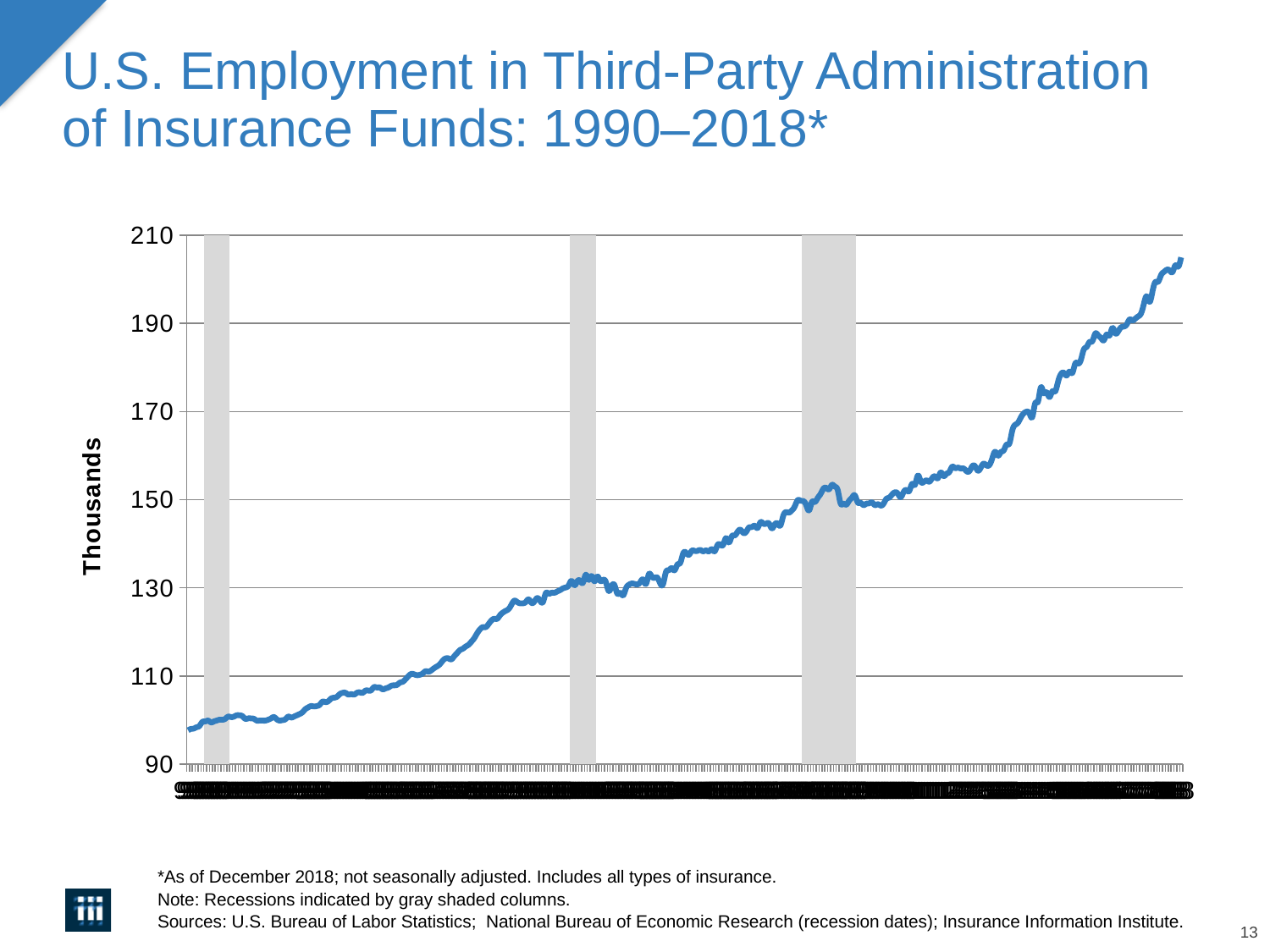
Is the lowest value reached by the line greater or less than 110? less Overall, do the values rise or fall from left to right along the x axis? rise Is the value at the end of the series (right end) greater or less than 190? greater Is the highest value reached by the line greater or less than 200? greater What is the label on the y axis? Thousands What is the highest tick value shown on the y axis? 210 What kind of chart is shown on the slide? line chart